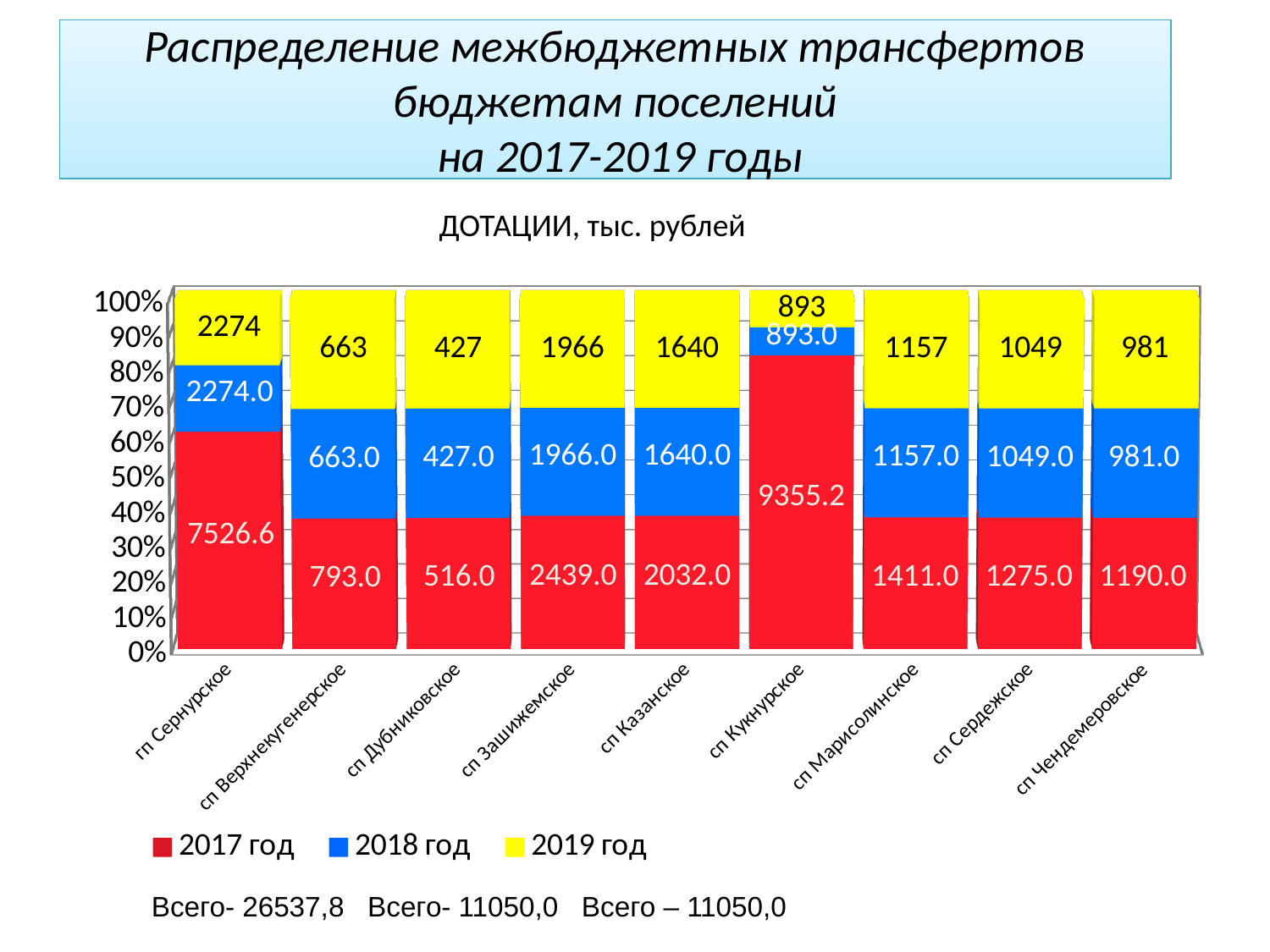
How many series does the legend list? 3 What is the value for сп Кукнурское in the 2017 год series? 9355.2 Which category has the highest value in the 2017 год series? сп Кукнурское What is the total of the three stacked values for сп Верхнекугенерское? 2119.0 Which category has the lowest value in the 2018 год series? сп Дубниковское What is the difference between the 2017 год values for гп Сернурское and сп Дубниковское? 7010.6 Which is larger: the 2018 год value for сп Казанское or for сп Марисолинское? сп Казанское What is the value for сп Чендемеровское in the 2019 год series? 981 What is the value for сп Зашижемское in the 2018 год series? 1966.0 How many categories are shown on the x axis? 9 What is the title of the chart? ДОТАЦИИ, тыс. рублей What kind of chart is shown on the slide? 100% stacked bar chart